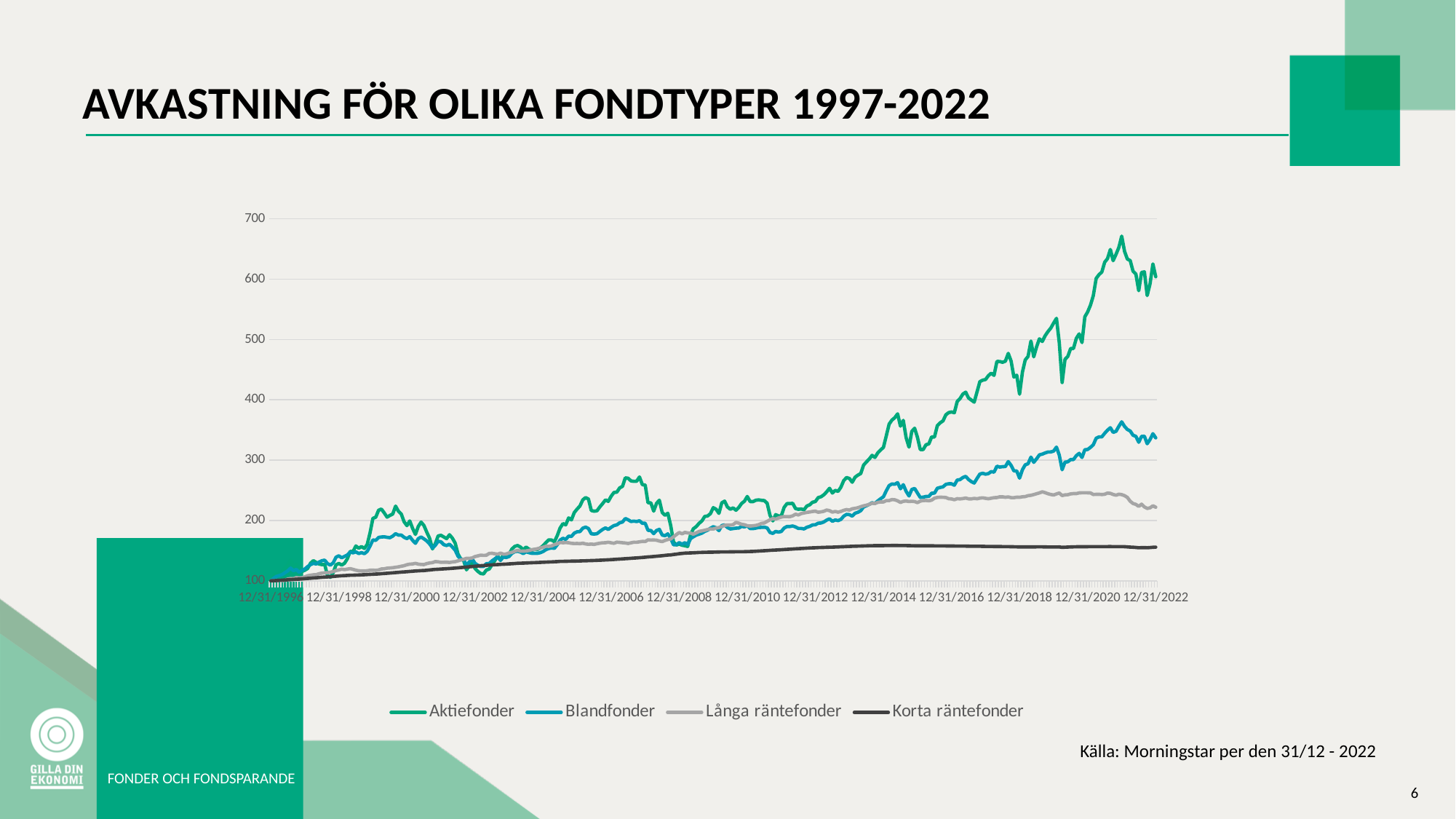
Which series has the highest value at the end of the chart (12/31/2022)? Aktiefonder Does the Korta räntefonder line rise or fall overall from 12/31/1996 to 12/31/2022? Rises Is the value for Aktiefonder at 12/31/2022 greater or less than 500? greater What kind of chart is shown on the slide? Line chart Is the value for Korta räntefonder at 12/31/2022 greater or less than 200? less How many series does the chart legend list? 4 At what value do all four series start at 12/31/1996? 100 Is the value for Blandfonder at 12/31/2022 greater or less than 300? greater At 12/31/2022, which is larger: Blandfonder or Långa räntefonder? Blandfonder What is the title of the chart slide? AVKASTNING FÖR OLIKA FONDTYPER 1997-2022 Which series has the lowest value at the end of the chart (12/31/2022)? Korta räntefonder